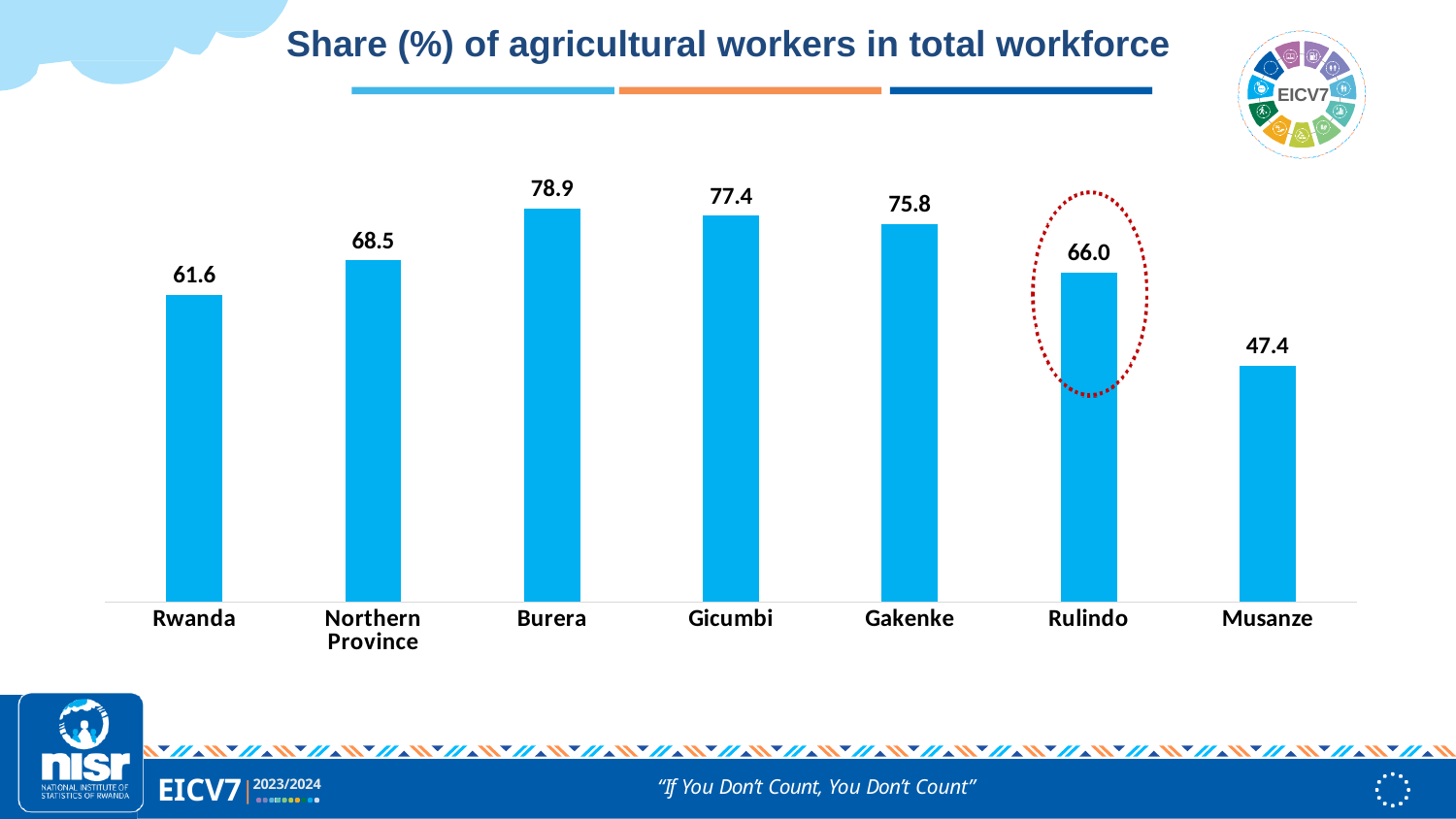
Which category has the highest share of agricultural workers? Burera Which category has the lowest share of agricultural workers? Musanze What is the value shown for Northern Province? 68.5 Which bar is highlighted with a dotted red circle? Rulindo What is the difference between the values for Northern Province and Rwanda? 6.9 Which has a larger value, Gicumbi or Gakenke? Gicumbi What is the share of agricultural workers in the total workforce for Rulindo? 66.0 What is the difference between the values for Burera and Musanze? 31.5 How many categories are shown on the chart? 7 What is the value shown for Rwanda? 61.6 What kind of chart is shown on the slide? Bar chart What is the value shown for Burera? 78.9